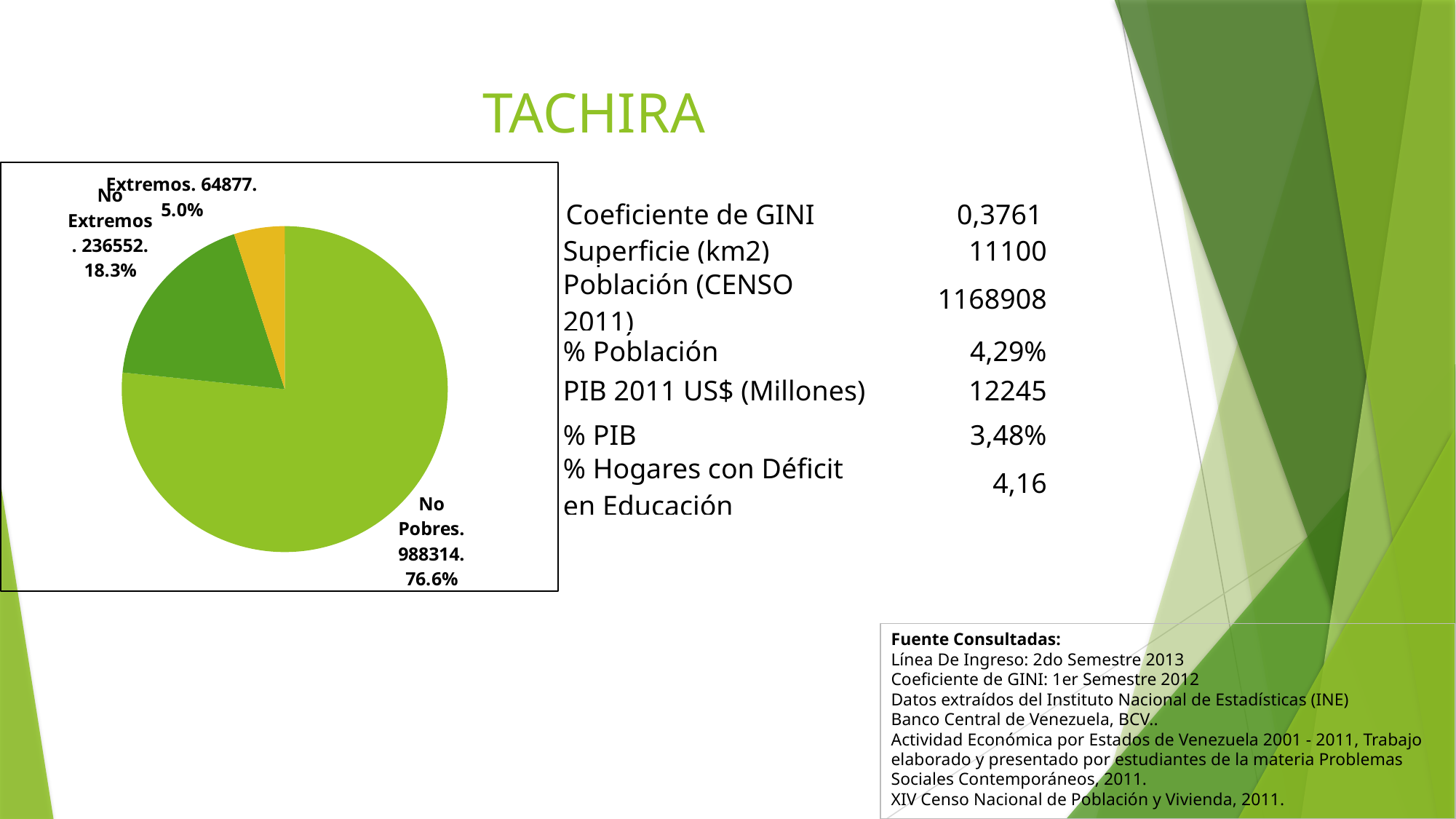
Which is larger in the pie chart, the No Extremos slice or the Extremos slice? No Extremos What kind of chart is shown on the slide? pie chart What share of the pie does the Extremos slice represent? 5.0% What share of the pie does the No Pobres slice represent? 76.6% What value is shown for the Extremos slice of the pie chart? 64877 How many slices does the pie chart have? 3 What is the difference between the No Extremos value and the Extremos value in the pie chart? 171675 Which slice of the pie chart is the largest? No Pobres What value is shown for the No Pobres slice of the pie chart? 988314 Which slice of the pie chart is the smallest? Extremos What share of the pie does the No Extremos slice represent? 18.3% What value is shown for the No Extremos slice of the pie chart? 236552